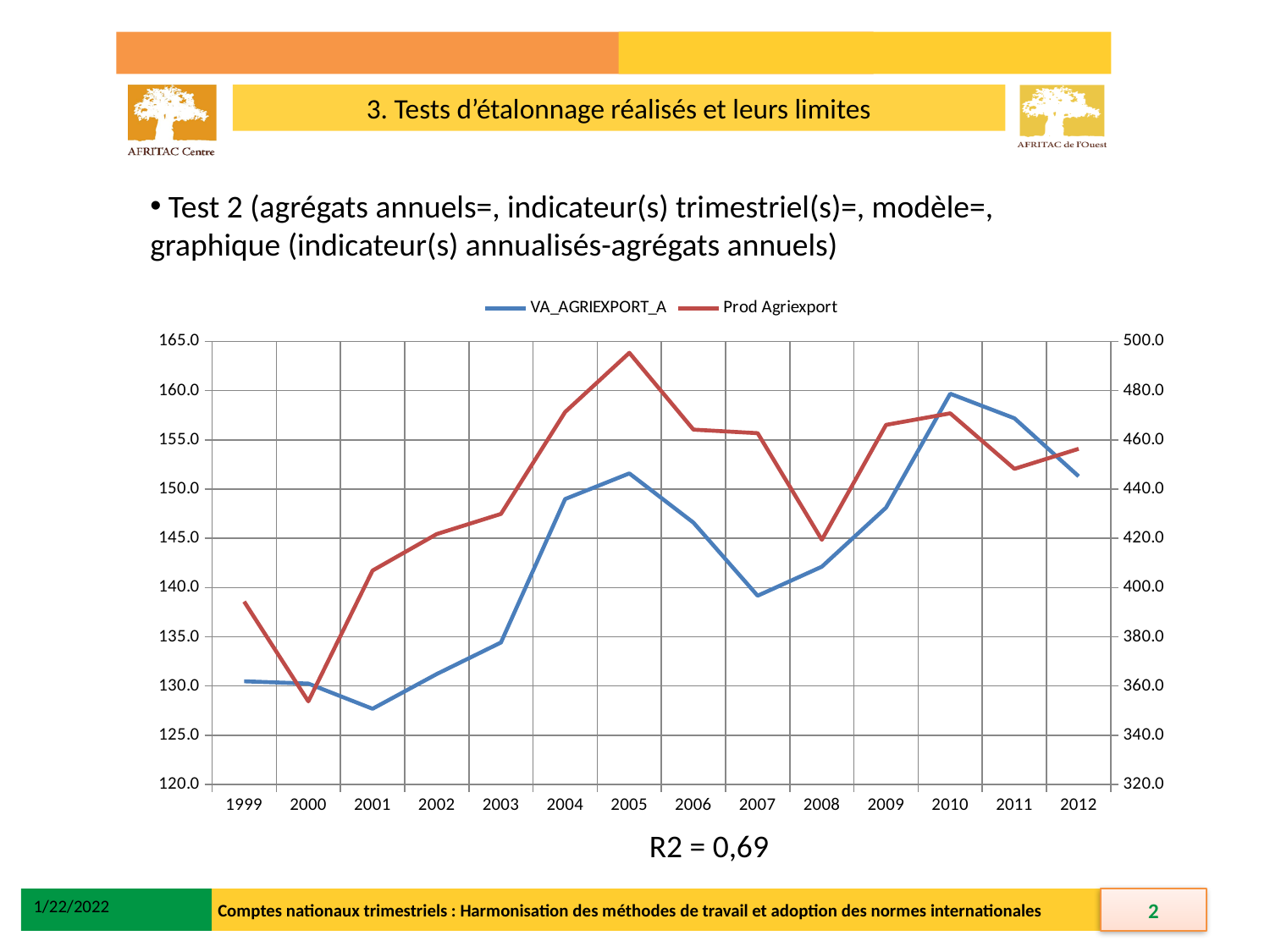
Which year has the larger Prod Agriexport value, 2000 or 2005? 2005 In which year does the Prod Agriexport series reach its highest value? 2005 Does the VA_AGRIEXPORT_A series rise or fall between 2001 and 2005? rise What kind of chart is shown on the slide? line chart How many years are plotted along the x axis of the chart? 14 In which year does the VA_AGRIEXPORT_A series reach its lowest value? 2001 How many series does the chart legend list? 2 What R2 value is printed below the chart? R2 = 0,69 In which year does the VA_AGRIEXPORT_A series reach its highest value? 2010 Is the Prod Agriexport value for 2005 greater or less than 480? greater Is the VA_AGRIEXPORT_A value for 2007 greater or less than 140? less In which year does the Prod Agriexport series reach its lowest value? 2000